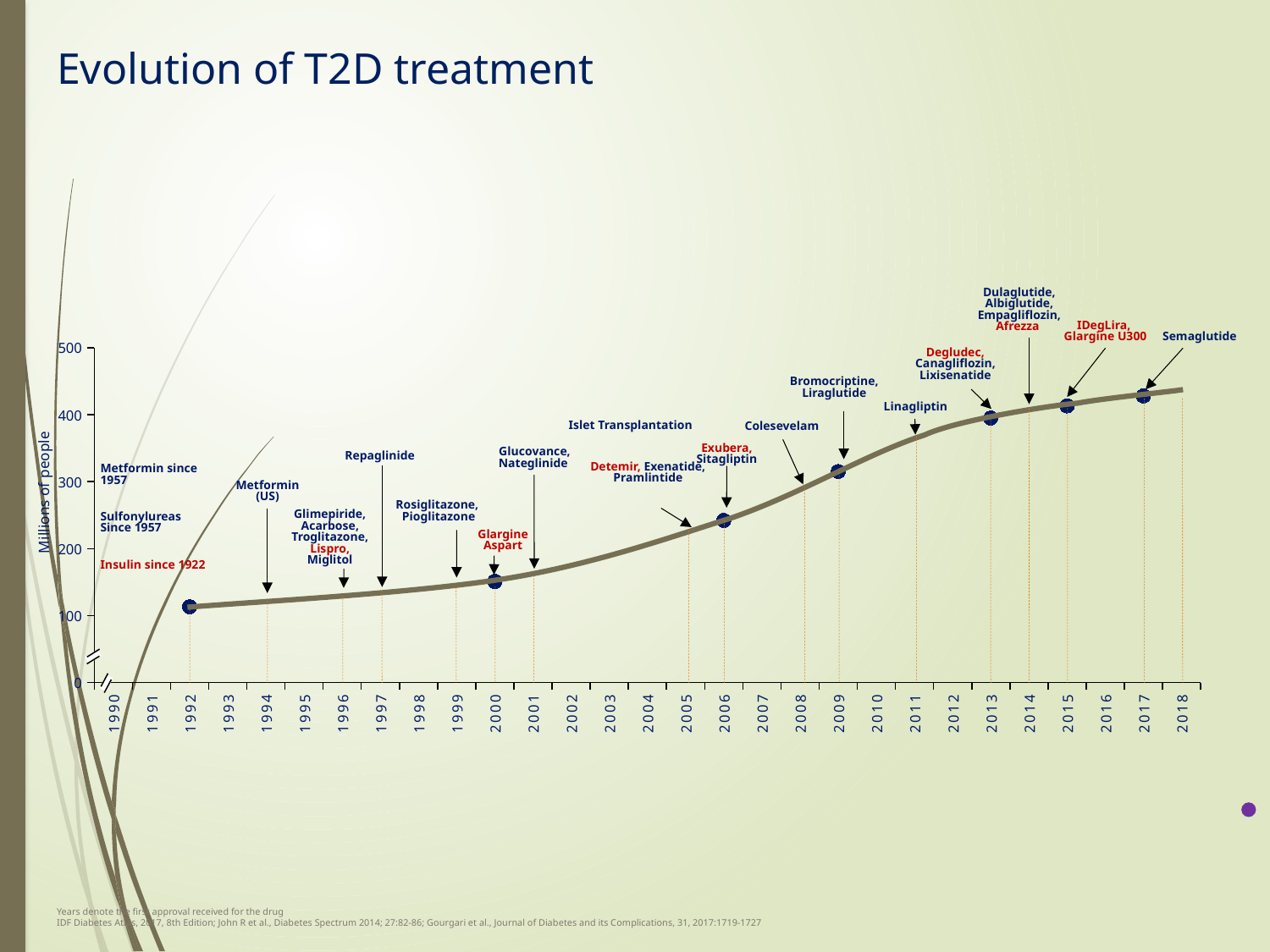
What is the label on the vertical axis? Millions of people Which plotted year has the lowest value? 1992 Does the plotted line rise or fall from 1990 to 2018? rises What kind of chart is shown on the slide? line chart Is the value for 1992 greater or less than 200? less Is the value for 2000 greater or less than 100? greater Is the value for 2017 greater or less than 400? greater What is the title of the chart? Evolution of T2D treatment Which is larger, the value for 2009 or the value for 2000? 2009 How many data point markers are plotted on the line? 7